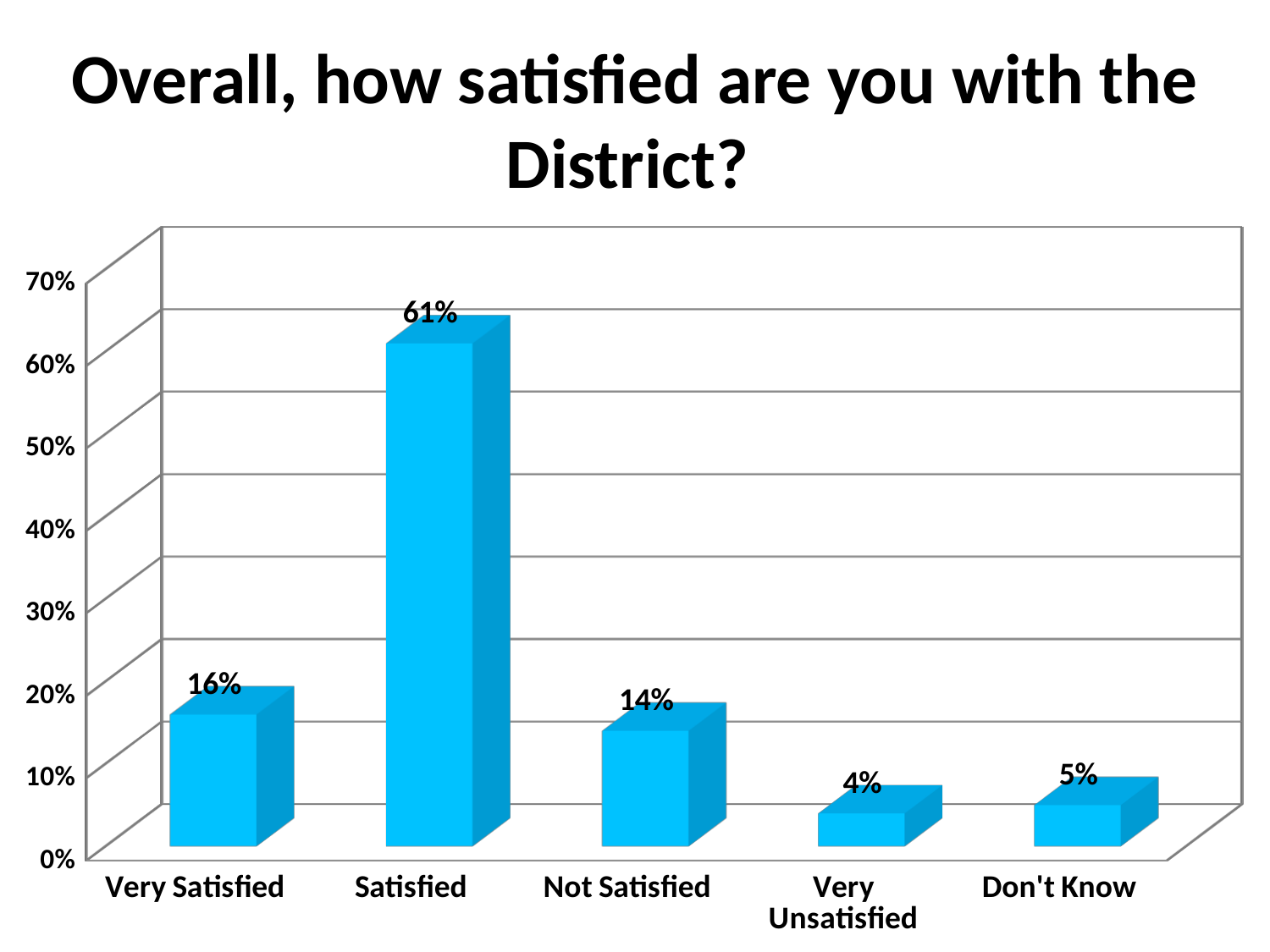
What is the value shown for "Don't Know"? 5% Which response category has the lowest value? Very Unsatisfied Is the value for "Satisfied" greater or less than 50%? greater Which is larger, the value for "Very Satisfied" or the value for "Not Satisfied"? Very Satisfied What percentage of respondents answered "Satisfied"? 61% What is the title of the chart? Overall, how satisfied are you with the District? What is the difference between the "Satisfied" and "Very Satisfied" values? 45% What is the value shown for "Not Satisfied"? 14% What is the value shown for "Very Satisfied"? 16% How many response categories are shown on the x axis? 5 What kind of chart is shown on the slide? Bar chart Which response category has the highest value? Satisfied